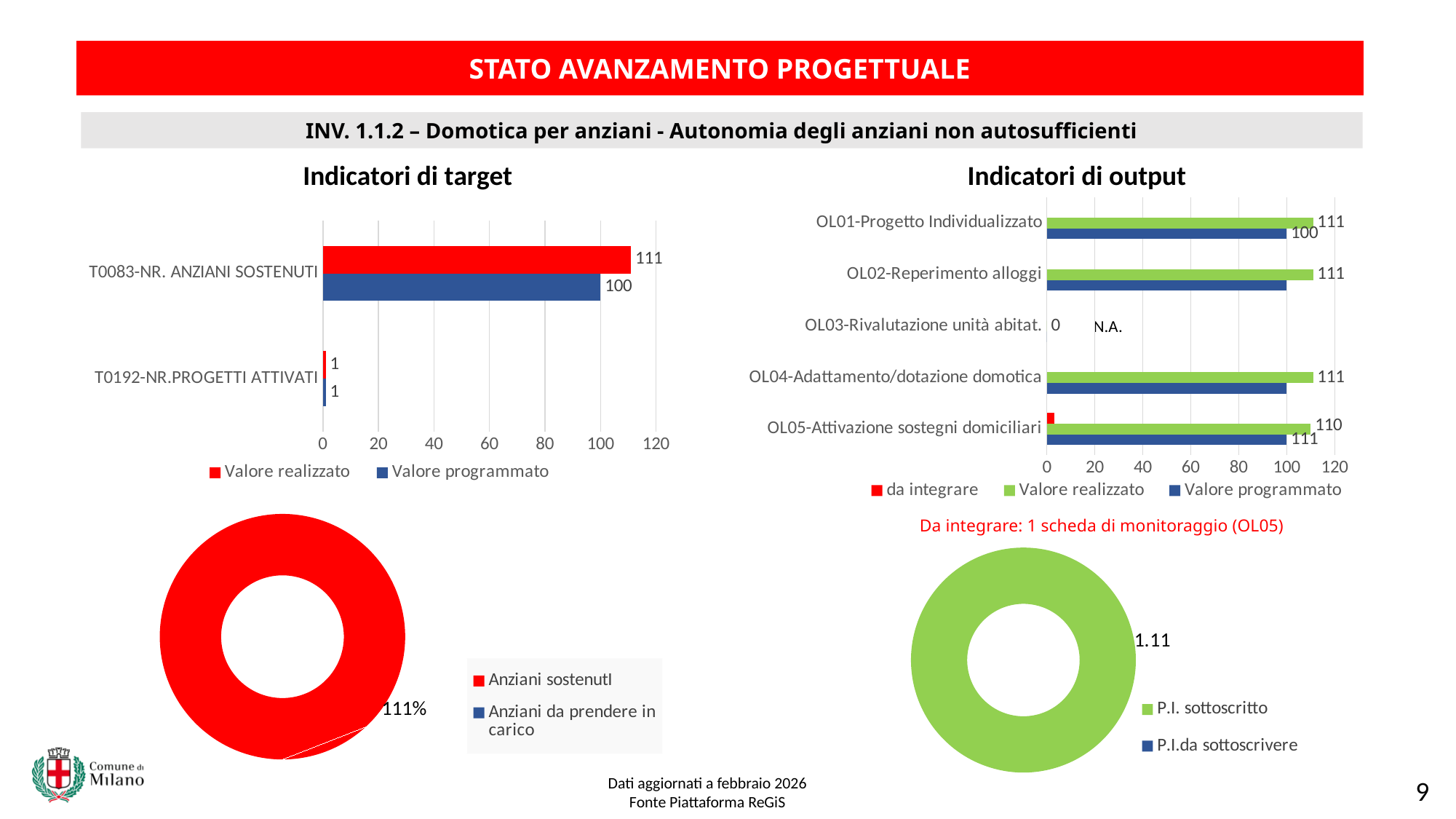
What value is printed on the bottom-left red donut chart? 111% How many series does the legend of the 'Indicatori di output' chart list? 3 How many categories are shown in the 'Indicatori di output' chart? 5 What kind of chart is the 'Indicatori di output' chart? bar chart In the 'Indicatori di output' chart, what is the Valore realizzato for OL05-Attivazione sostegni domiciliari? 110 In the 'Indicatori di target' chart, what is the difference between the Valore realizzato and the Valore programmato for T0083-NR. ANZIANI SOSTENUTI? 11 In the 'Indicatori di output' chart, what is the Valore programmato for OL01-Progetto Individualizzato? 100 In the 'Indicatori di target' chart, what is the Valore realizzato for T0083-NR. ANZIANI SOSTENUTI? 111 How many categories are shown in the 'Indicatori di target' chart? 2 In the 'Indicatori di output' chart, is the Valore programmato for OL04-Adattamento/dotazione domotica greater or less than 80? greater In the 'Indicatori di target' chart, what is the Valore programmato for T0083-NR. ANZIANI SOSTENUTI? 100 In the 'Indicatori di target' chart, which is larger for T0083-NR. ANZIANI SOSTENUTI: Valore realizzato or Valore programmato? Valore realizzato